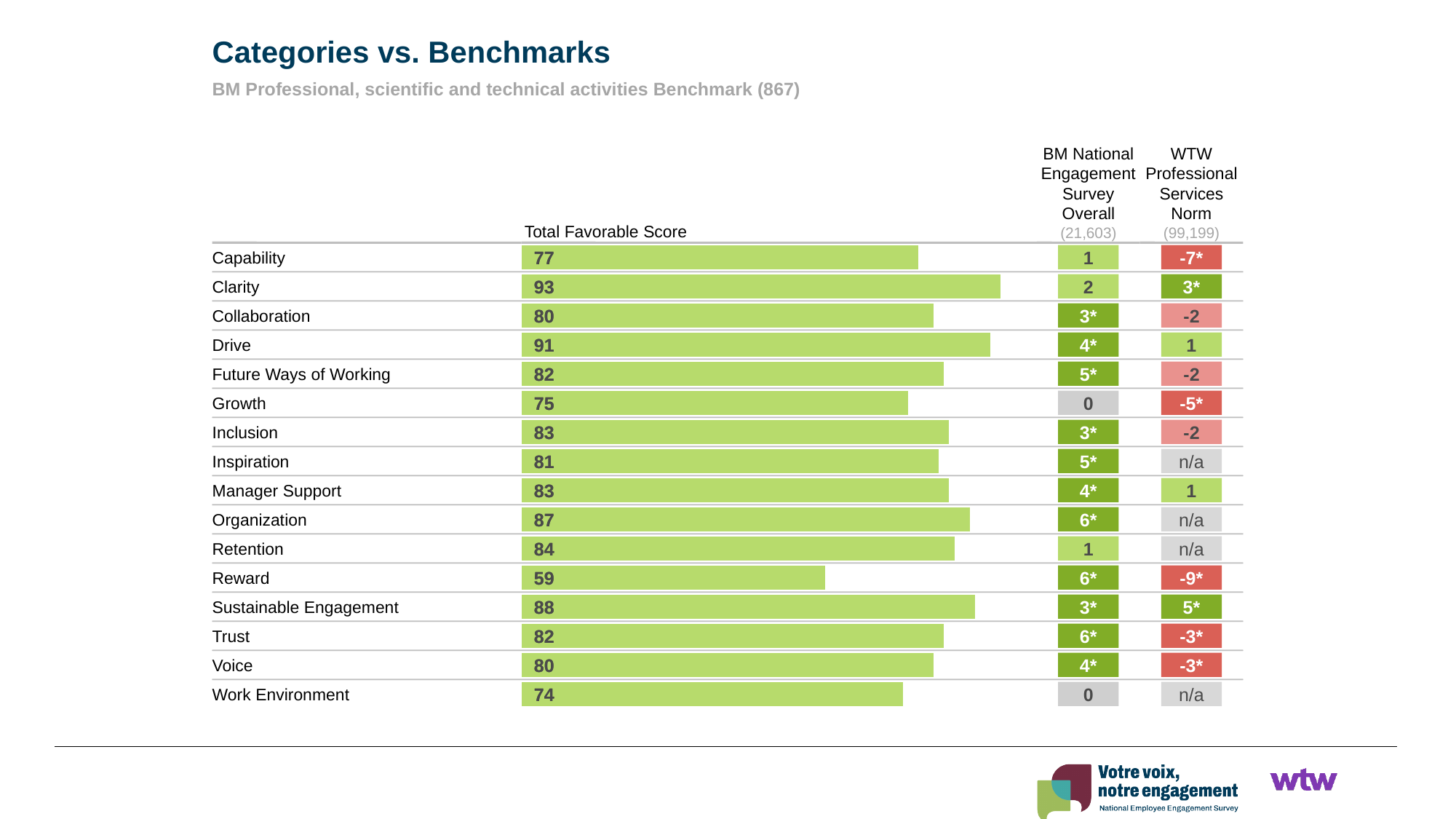
Which category has the highest Total Favorable Score? Clarity What is the Total Favorable Score for Reward? 59 What is the Total Favorable Score for Work Environment? 74 How many categories are shown in the chart? 16 Which has a higher Total Favorable Score, Organization or Retention? Organization What is the difference between the Total Favorable Scores for Drive and Growth? 16 What kind of chart is used to show the Total Favorable Score? Bar chart What is the value shown for Organization in the BM National Engagement Survey Overall column? 6* What is the Total Favorable Score for Clarity? 93 Which category has the lowest Total Favorable Score? Reward What is the title of the slide? Categories vs. Benchmarks What is the value shown for Capability in the WTW Professional Services Norm column? -7*